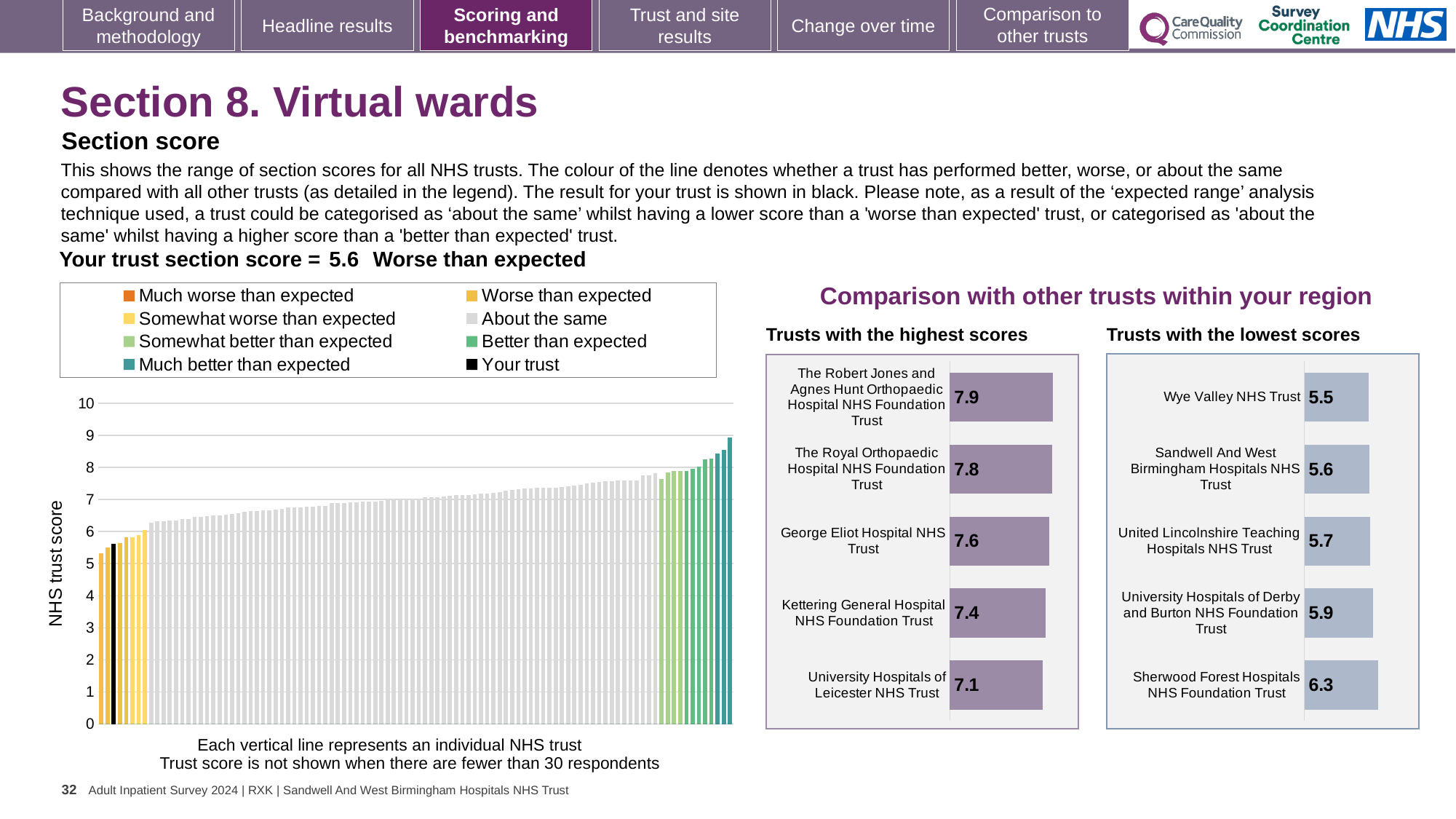
How many trusts are shown in the 'Trusts with the lowest scores' chart? 5 How many entries does the legend of the large chart on the left list? 8 In the 'Trusts with the highest scores' chart, what is the difference between the scores of The Robert Jones and Agnes Hunt Orthopaedic Hospital NHS Foundation Trust and University Hospitals of Leicester NHS Trust? 0.8 What is the section score for your trust shown on the slide? 5.6 In the 'Trusts with the highest scores' chart, what is the score for The Robert Jones and Agnes Hunt Orthopaedic Hospital NHS Foundation Trust? 7.9 In the 'Trusts with the highest scores' chart, what is the score for Kettering General Hospital NHS Foundation Trust? 7.4 In the 'Trusts with the highest scores' chart, which trust has the lowest score? University Hospitals of Leicester NHS Trust In the large chart on the left showing all NHS trusts, is the value of the tallest bar greater or less than 8? greater In the 'Trusts with the lowest scores' chart, which trust has the highest score? Sherwood Forest Hospitals NHS Foundation Trust In the 'Trusts with the lowest scores' chart, what is the score for Wye Valley NHS Trust? 5.5 In the large chart on the left showing all NHS trusts, do the values rise or fall from left to right? rise In the 'Trusts with the lowest scores' chart, which has the larger score: United Lincolnshire Teaching Hospitals NHS Trust or Sandwell And West Birmingham Hospitals NHS Trust? United Lincolnshire Teaching Hospitals NHS Trust